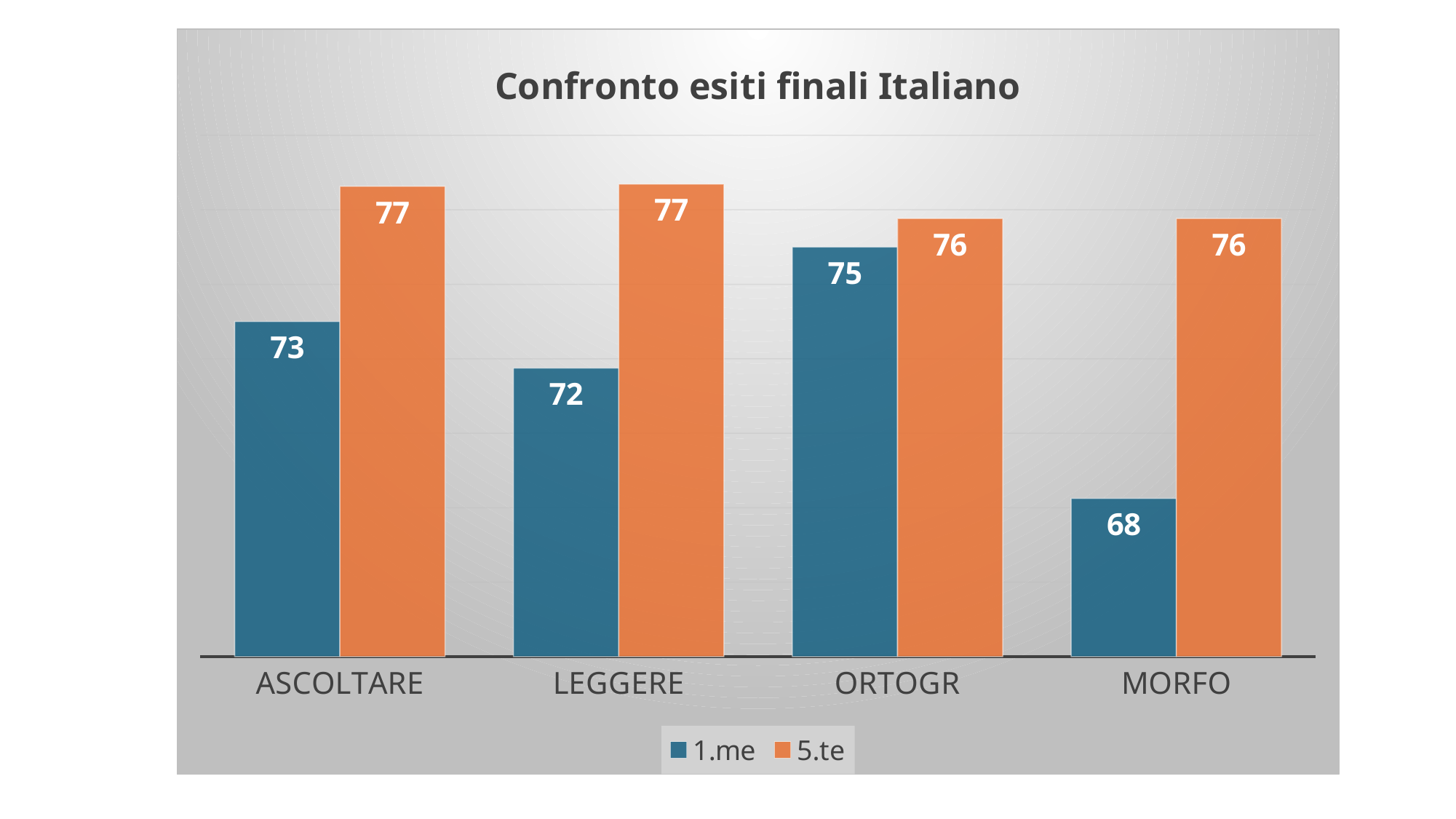
What is the value for 5.te in the MORFO category? 76 How many series does the legend list? 2 What is the value for 1.me in the ASCOLTARE category? 73 Which category has the lowest value for the 1.me series? MORFO Which category has the highest value for the 1.me series? ORTOGR In the ORTOGR category, which series has the larger value, 1.me or 5.te? 5.te What is the difference between the 5.te and 1.me values in the MORFO category? 8 What is the difference between the 5.te and 1.me values in the LEGGERE category? 5 How many categories are shown on the x axis? 4 What is the value for 1.me in the ORTOGR category? 75 What kind of chart is shown on the slide? Bar chart What is the title of the chart? Confronto esiti finali Italiano